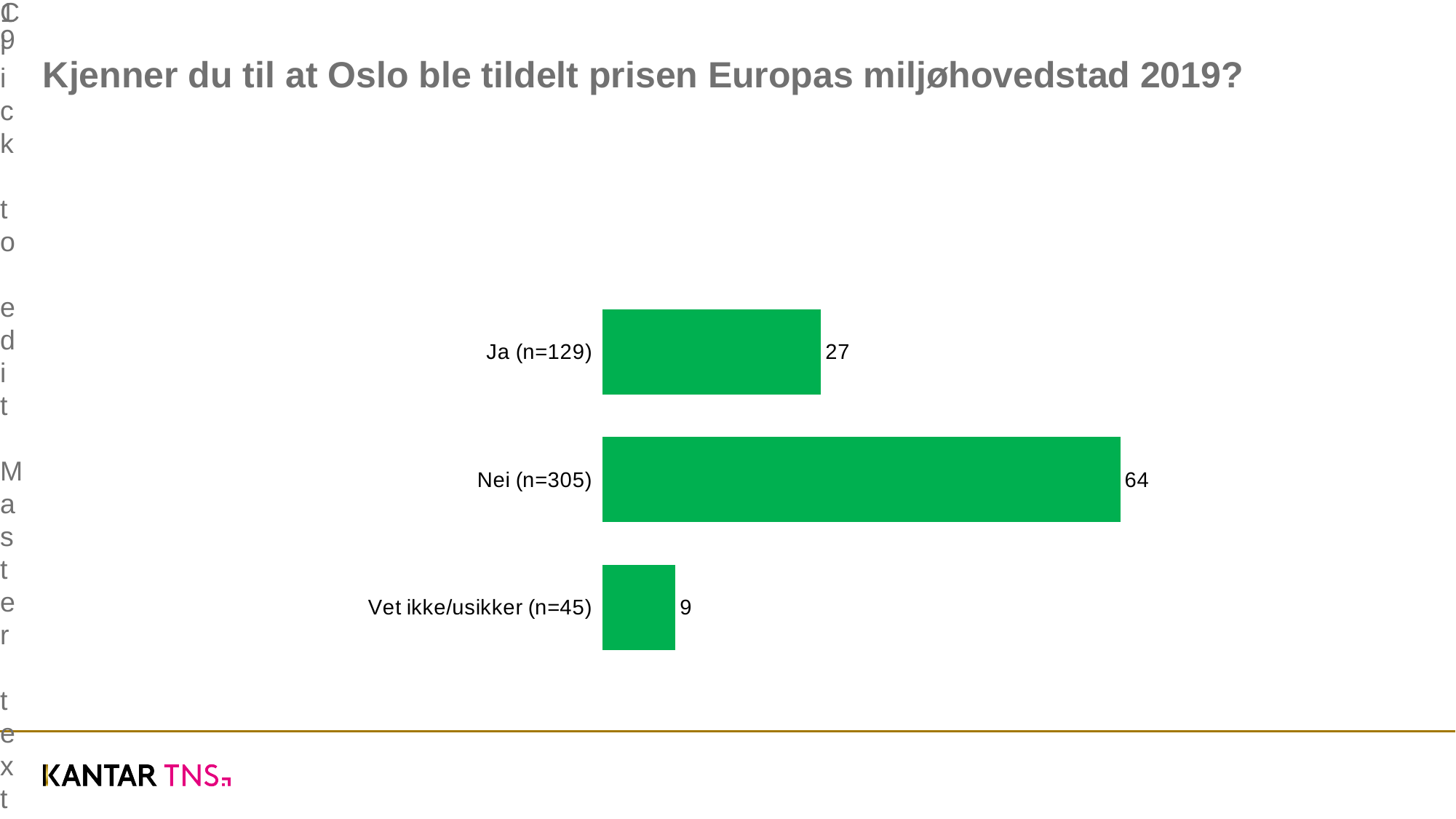
Which category has the lowest value? Vet ikke/usikker (n=45) What is the title of the slide? Kjenner du til at Oslo ble tildelt prisen Europas miljøhovedstad 2019? Which is larger, the value for Ja (n=129) or the value for Nei (n=305)? Nei (n=305) What is the difference between the values for Ja (n=129) and Vet ikke/usikker (n=45)? 18 How many categories are shown in the chart? 3 What is the value for Ja (n=129)? 27 What is the total of the three values shown in the chart? 100 What is the value for Vet ikke/usikker (n=45)? 9 What is the difference between the values for Nei (n=305) and Ja (n=129)? 37 What is the value for Nei (n=305)? 64 What kind of chart is shown on the slide? Bar chart Which category has the highest value? Nei (n=305)